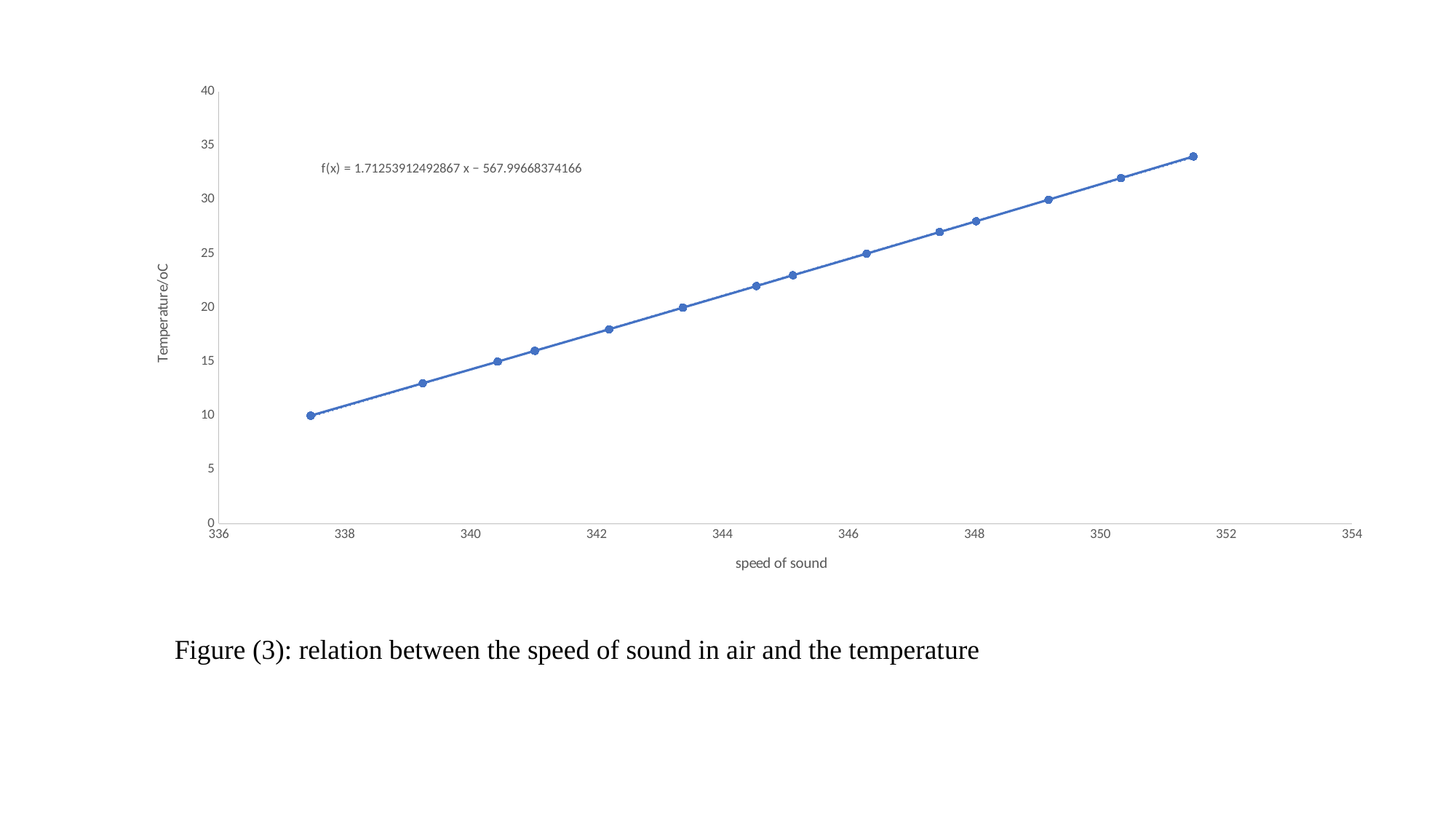
Is the temperature value for the rightmost data point greater or less than 30? greater What kind of chart is shown on the slide? scatter chart Do the temperature values rise or fall as the speed of sound increases along the x axis? rise Is the temperature value at a speed of sound of about 340 greater or less than 20? less What is the title of the x axis? speed of sound What is the title of the y axis? Temperature/oC Is the temperature value for the leftmost data point greater or less than 15? less What is the highest tick value shown on the y axis? 40 Which data point has the highest temperature, the leftmost or the rightmost? the rightmost How many data points are plotted on the chart? 14